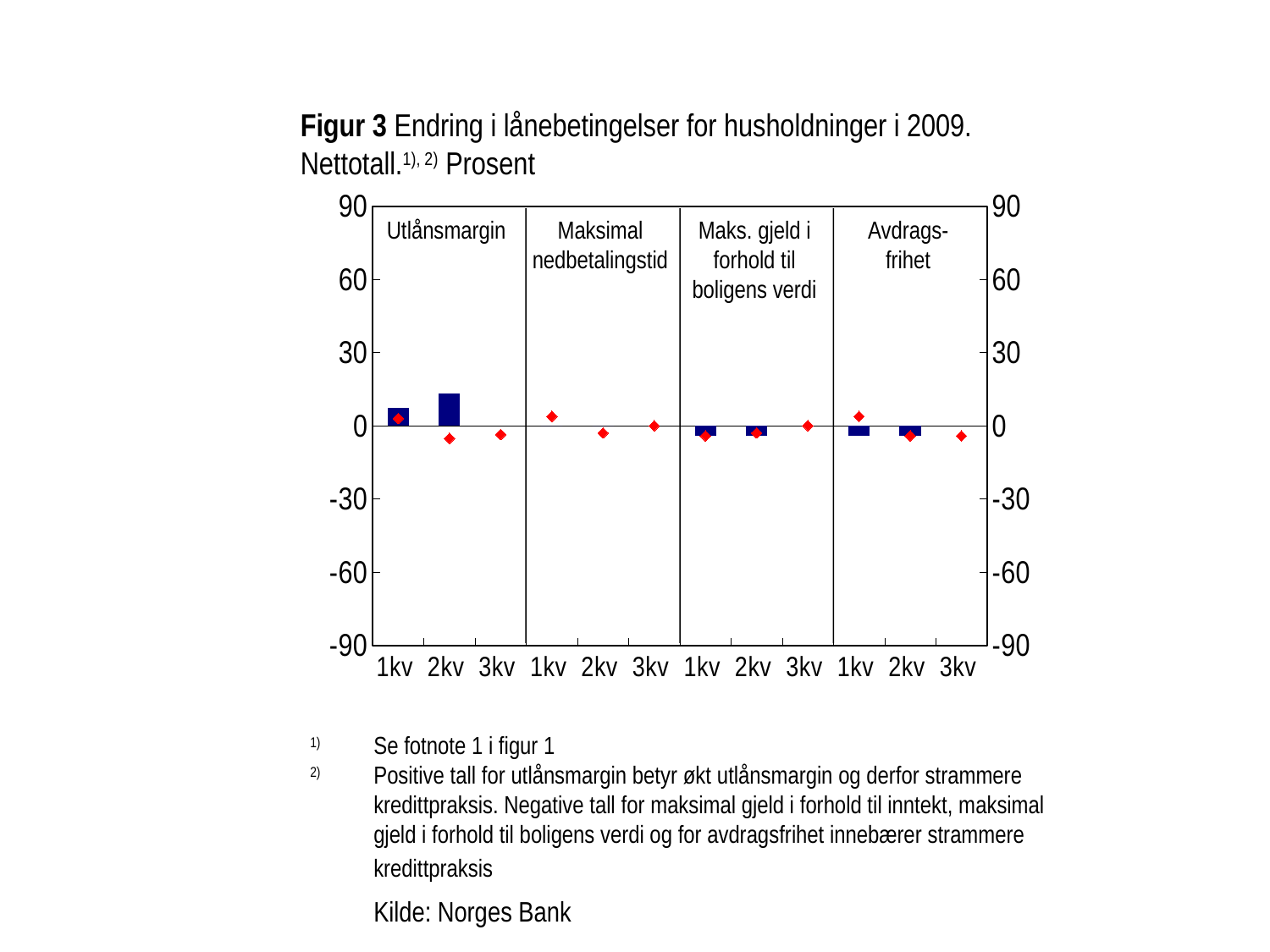
Is the bar for 1kv in the Utlånsmargin panel greater or less than 0? greater What is the lowest value shown on the y axis? -90 What is the source given for the chart? Norges Bank Which is larger: the bar for 1kv or the bar for 2kv in the Utlånsmargin panel? 2kv Is the bar for 2kv in the Utlånsmargin panel greater or less than 30? less How many quarter categories are shown along the x axis in total? 12 What is the highest value shown on the y axis? 90 How many panels (loan-condition categories) does the chart have? 4 Is the bar for 2kv in the Utlånsmargin panel greater or less than 0? greater Which quarter in the Utlånsmargin panel has the tallest bar? 2kv What kind of chart is shown on the slide? combination bar and line chart (bars with diamond markers)